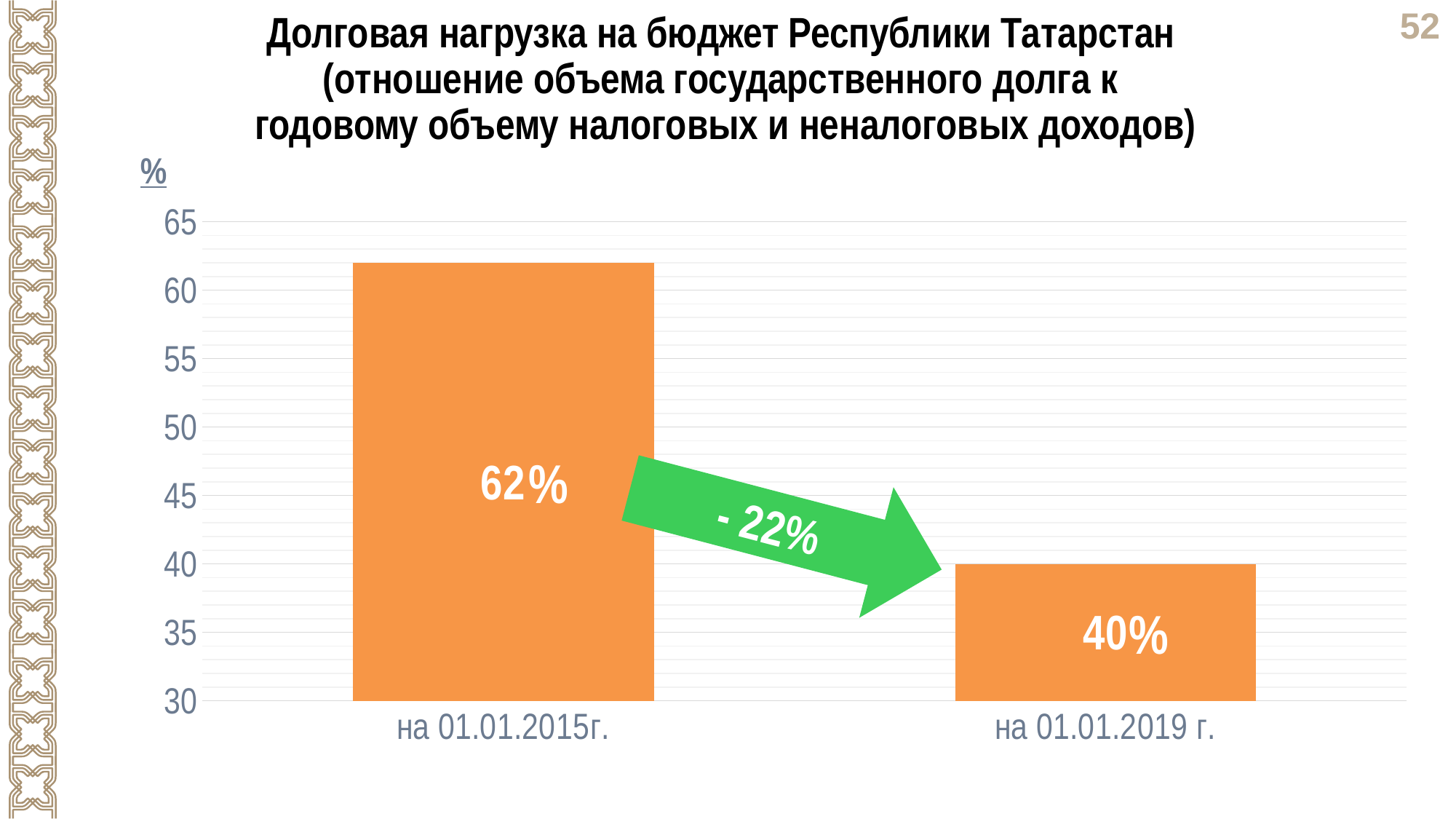
What is the difference between the value for на 01.01.2015г. and the value for на 01.01.2019 г.? 22% What kind of chart is shown on the slide? bar chart Which date has the lower debt load value? на 01.01.2019 г. Do the values rise or fall from на 01.01.2015г. to на 01.01.2019 г.? fall Is the value for на 01.01.2015г. larger or smaller than the value for на 01.01.2019 г.? larger Which date has the higher debt load value? на 01.01.2015г. Is the value for на 01.01.2015г. greater or less than 60? greater What is the debt load value shown for на 01.01.2019 г.? 40% Is the value for на 01.01.2019 г. greater or less than 45? less How many bars are plotted on the chart? 2 What is the debt load value shown for на 01.01.2015г.? 62% What change is written on the green arrow between the two bars? - 22%